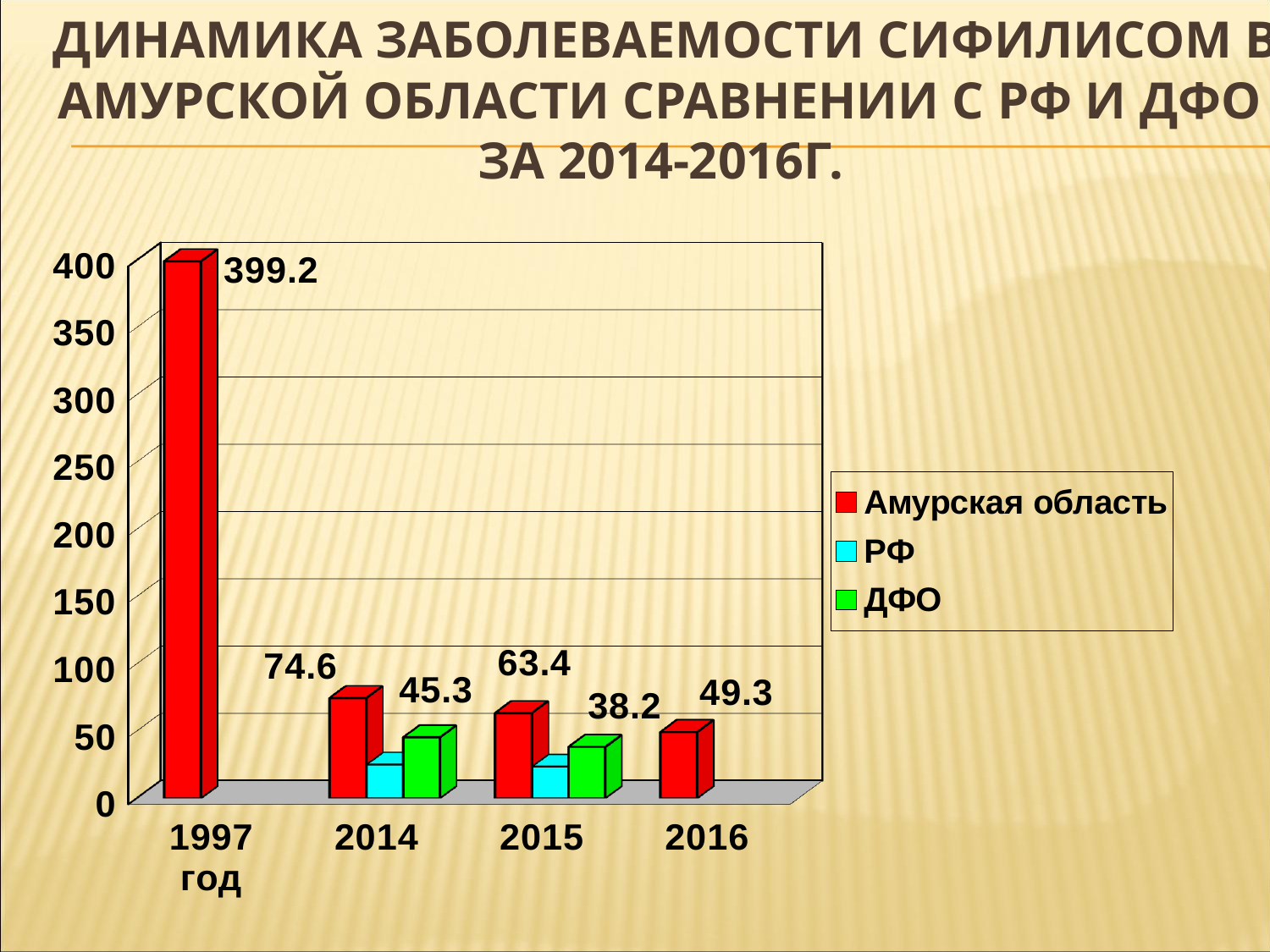
In which year is the value for Амурская область lowest? 2016 What is the difference between the Амурская область values for 2014 and 2015? 11.2 What is the value for Амурская область in 1997 год? 399.2 Is the value for РФ in 2014 greater or less than 50? less How many year categories are shown on the x axis? 4 In which year is the value for Амурская область highest? 1997 год What is the value for ДФО in 2015? 38.2 What is the value for Амурская область in 2014? 74.6 What is the value for Амурская область in 2016? 49.3 What kind of chart is shown on the slide? bar chart How many series does the legend list? 3 Which is larger in 2014: the value for Амурская область or the value for ДФО? Амурская область